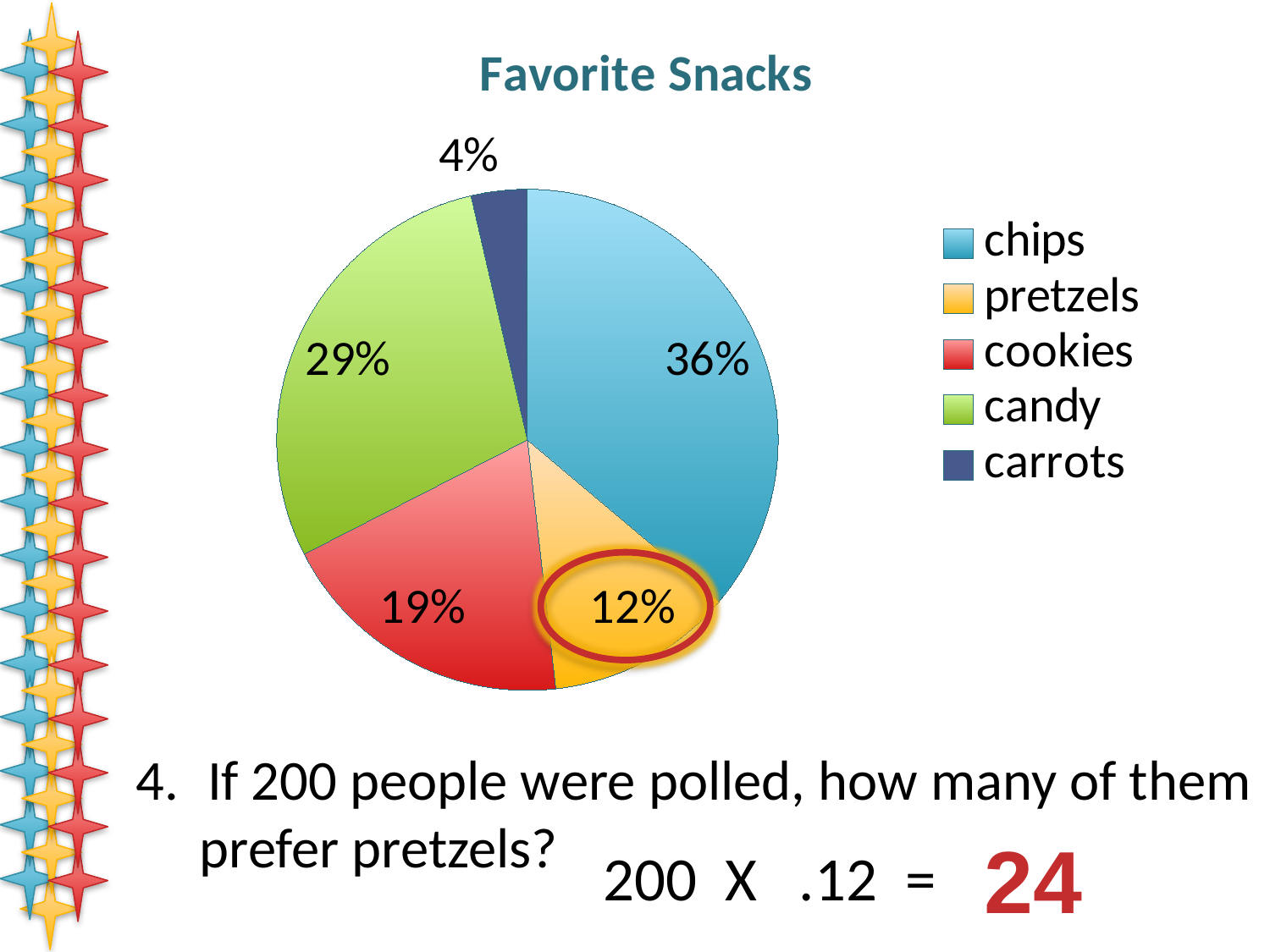
What percentage of the pie chart is for chips? 36% Which snack has the largest share of the pie chart? chips Which has a larger share, cookies or pretzels? cookies What is the difference in percentage points between cookies and pretzels? 7 Which snack has the smallest share of the pie chart? carrots What kind of chart is shown on the slide? pie chart What is the title of the chart? Favorite Snacks What percentage of the pie chart is for carrots? 4% Which slice of the pie chart is circled in red? pretzels (12%) What percentage of the pie chart is for candy? 29% How many slices does the pie chart have? 5 What is the difference in percentage points between chips and candy? 7